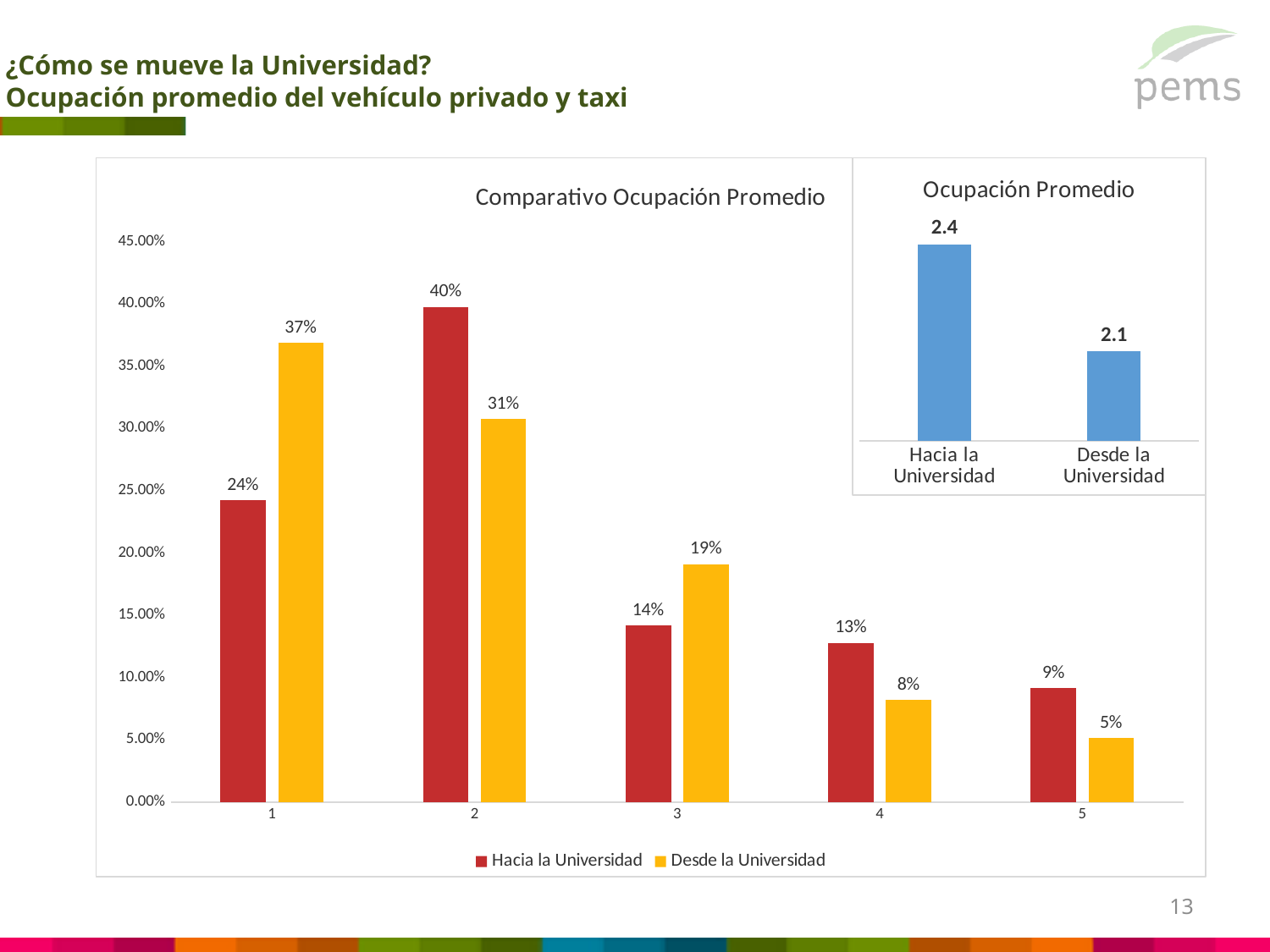
In the 'Comparativo Ocupación Promedio' chart, which category has the lowest value for 'Desde la Universidad'? 5 In the 'Comparativo Ocupación Promedio' chart, what is the difference between 'Hacia la Universidad' and 'Desde la Universidad' at category 1? 13% In the 'Ocupación Promedio' chart on the right, what is the difference between 'Hacia la Universidad' and 'Desde la Universidad'? 0.3 In the 'Comparativo Ocupación Promedio' chart, how many series does the legend list? 2 What kind of chart is the 'Comparativo Ocupación Promedio' chart? Bar chart In the 'Ocupación Promedio' chart on the right, what is the value for 'Hacia la Universidad'? 2.4 In the 'Comparativo Ocupación Promedio' chart, what colour are the 'Desde la Universidad' bars? Yellow In the 'Comparativo Ocupación Promedio' chart, what is the value for 'Hacia la Universidad' at category 2? 40% In the 'Comparativo Ocupación Promedio' chart, how many categories are shown on the x axis? 5 In the 'Comparativo Ocupación Promedio' chart, which category has the highest value for 'Hacia la Universidad'? 2 In the 'Comparativo Ocupación Promedio' chart, what is the value for 'Desde la Universidad' at category 1? 37% In the 'Comparativo Ocupación Promedio' chart, at category 3, which series has the larger value? Desde la Universidad